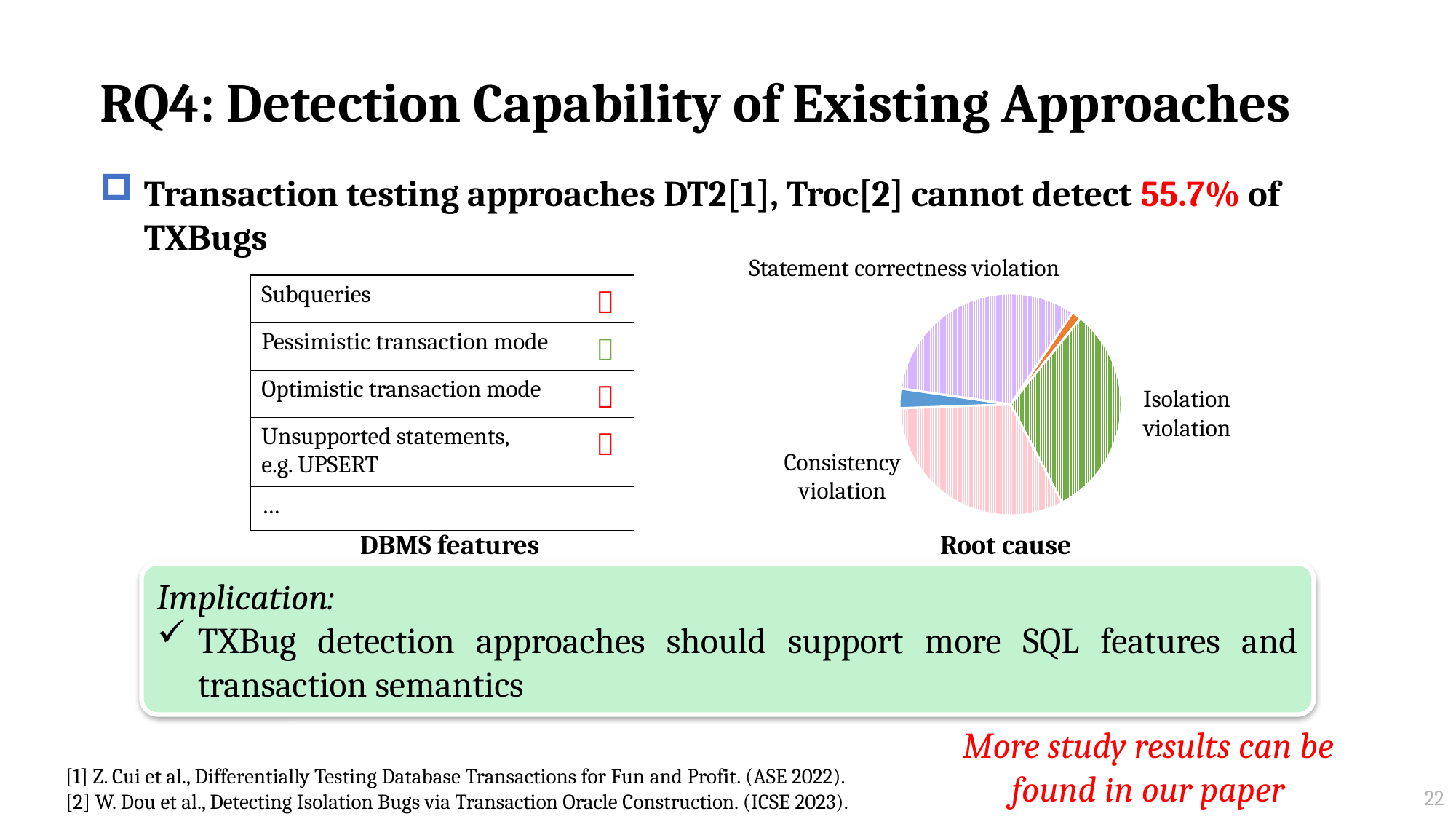
What kind of chart is shown under the heading "Root cause"? pie chart In the Root cause pie chart, which is larger, the blue slice or the orange slice? blue slice How many slices of the Root cause pie chart have a text label? 3 In the Root cause pie chart, which is larger, the Consistency violation slice or the orange slice? Consistency violation In the Root cause pie chart, which colour slice is the smallest? orange Which labelled root cause is shown by the green slice of the pie chart? Isolation violation What is the title printed below the pie chart? Root cause In the Root cause pie chart, which is larger, the Statement correctness violation slice or the blue slice? Statement correctness violation How many slices does the Root cause pie chart have? 5